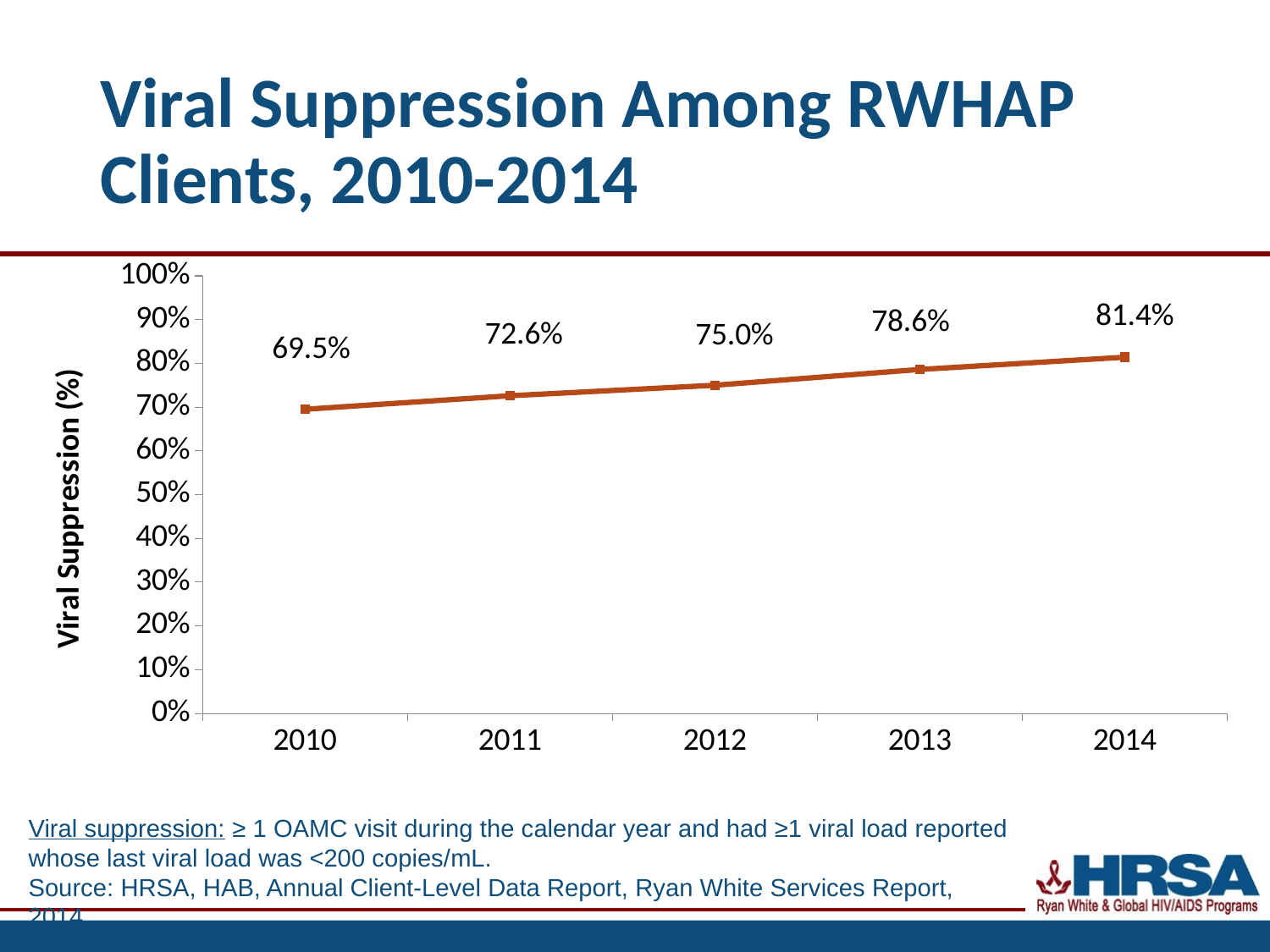
What kind of chart is shown on the slide? line chart What is the viral suppression percentage for 2010? 69.5% How many years are plotted on the chart? 5 What is the difference in viral suppression between 2013 and 2012? 3.6% Which year has a higher viral suppression percentage, 2011 or 2013? 2013 What is the difference in viral suppression between 2014 and 2010? 11.9% Does viral suppression rise or fall from 2010 to 2014? rise Which year has the lowest viral suppression percentage? 2010 Is the viral suppression value for 2013 greater or less than 70%? greater What is the viral suppression percentage for 2012? 75.0% What is the viral suppression percentage for 2014? 81.4% Which year has the highest viral suppression percentage? 2014